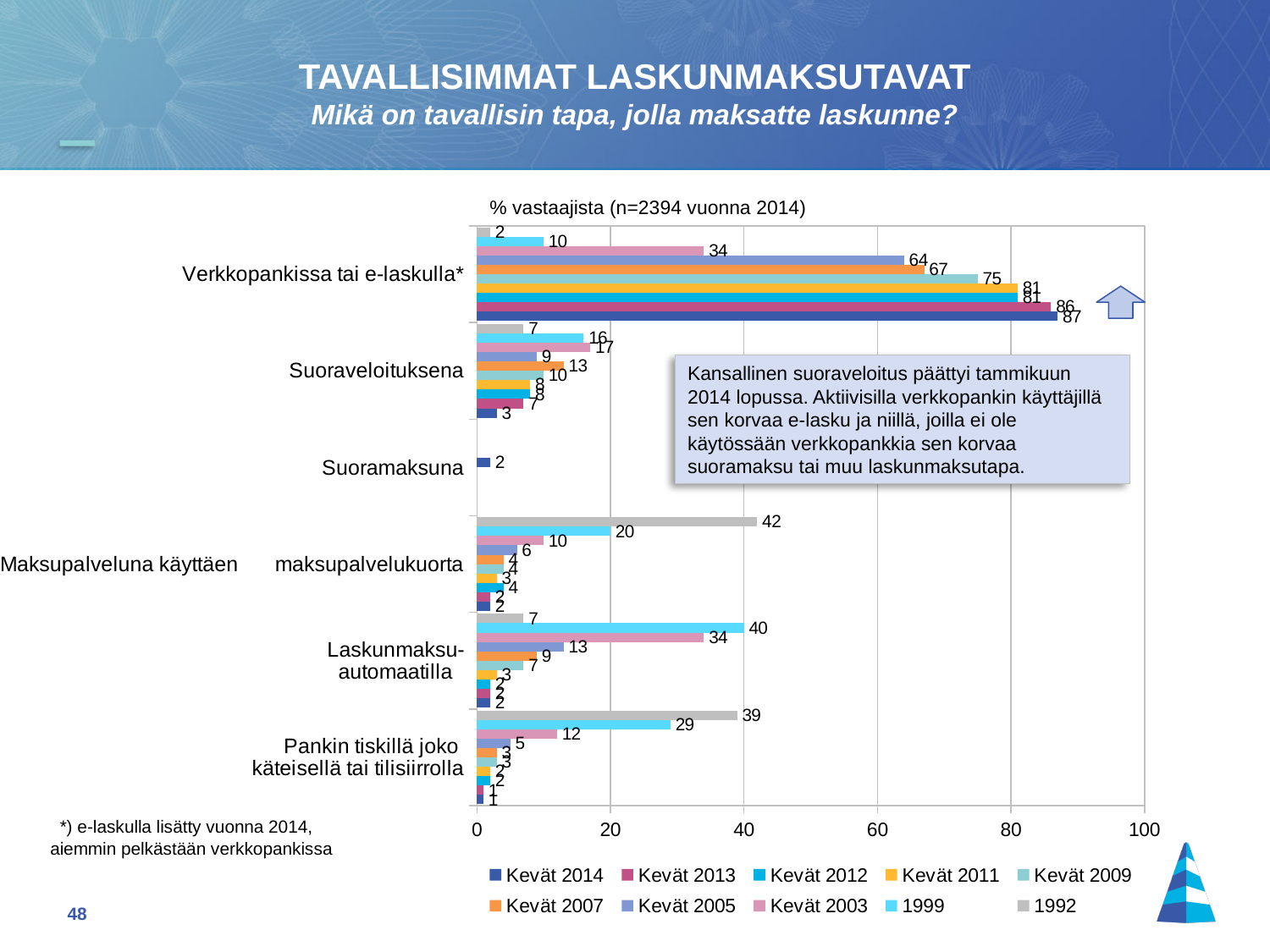
What is the value for Verkkopankissa tai e-laskulla* in Kevät 2014? 87 How many series does the legend list? 10 What is the value for Suoraveloituksena in Kevät 2003? 17 What label is shown above the chart describing the unit of the values? % vastaajista (n=2394 vuonna 2014) How many payment-method categories are shown on the chart? 6 Do the values for Verkkopankissa tai e-laskulla* rise or fall from 1992 to Kevät 2014? Rise In 1999, which is larger: the value for Laskunmaksuautomaatilla or for Pankin tiskillä joko käteisellä tai tilisiirrolla? Laskunmaksuautomaatilla Which category has the highest value for Kevät 2014? Verkkopankissa tai e-laskulla* What is the difference between the Kevät 2014 value and the 1992 value for Verkkopankissa tai e-laskulla*? 85 What is the value for Pankin tiskillä joko käteisellä tai tilisiirrolla in 1999? 29 What type of chart is shown on the slide? Bar chart What is the value for Maksupalveluna käyttäen maksupalvelukuorta in 1992? 42